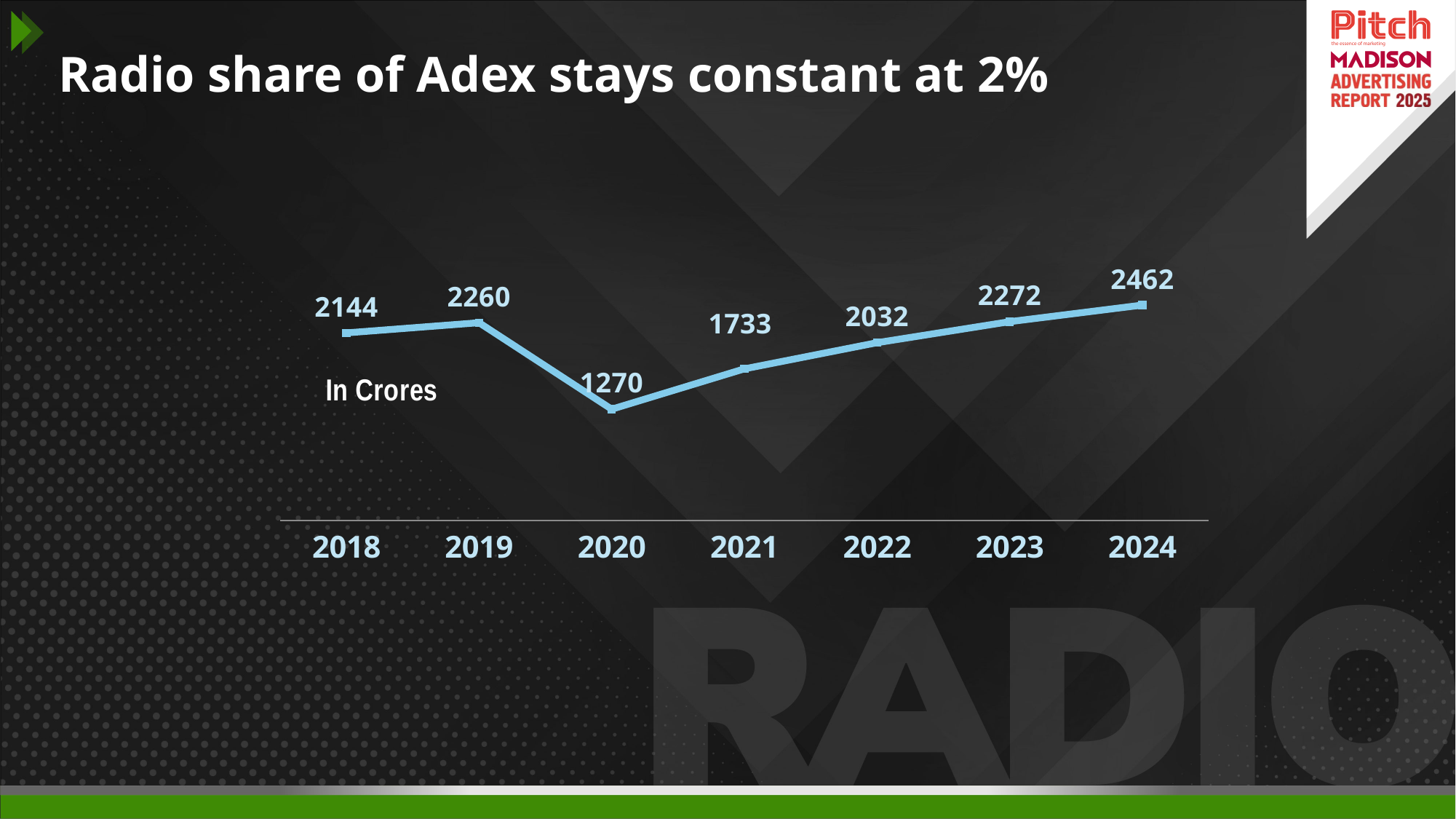
What kind of chart is shown on the slide? Line chart What is the difference between the values for 2024 and 2023? 190 What is the value for 2018? 2144 What is the value for 2024? 2462 What is the value for 2022? 2032 How many years are plotted on the chart? 7 Do the values rise or fall from 2020 to 2024? Rise What is the value for 2020? 1270 Which year has the highest value? 2024 What is the difference between the values for 2019 and 2020? 990 Which year has the lowest value? 2020 Which is larger, the value for 2019 or the value for 2021? 2019